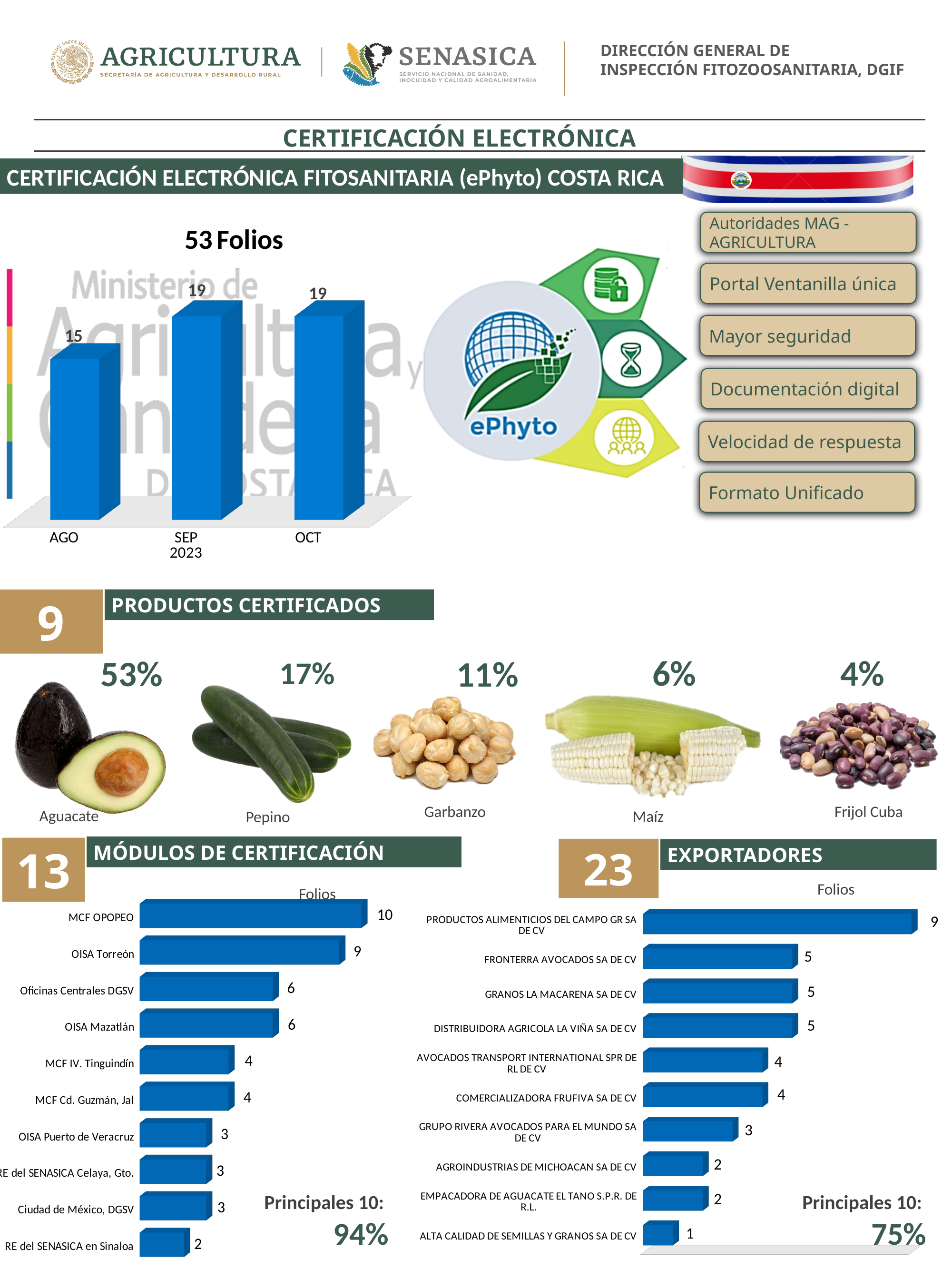
In the 'Exportadores' chart, which category has the lowest value? ALTA CALIDAD DE SEMILLAS Y GRANOS SA DE CV In the '53 Folios' chart, what is the difference between the values for SEP and AGO? 4 In the '53 Folios' chart, how many months are shown on the x axis? 3 In the 'Módulos de Certificación' chart, which category has the highest value? MCF OPOPEO In the '53 Folios' chart, what is the value for SEP? 19 In the 'Exportadores' chart, which is larger: FRONTERRA AVOCADOS SA DE CV or COMERCIALIZADORA FRUFIVA SA DE CV? FRONTERRA AVOCADOS SA DE CV In the 'Módulos de Certificación' chart, what is the difference between OISA Torreón and OISA Mazatlán? 3 In the '53 Folios' chart, what is the value for AGO? 15 In the 'Exportadores' chart, what is the value for PRODUCTOS ALIMENTICIOS DEL CAMPO GR SA DE CV? 9 What kind of chart is the '53 Folios' chart? Bar chart In the 'Módulos de Certificación' chart, what is the value for MCF OPOPEO? 10 In the '53 Folios' chart, which month has the lowest value? AGO